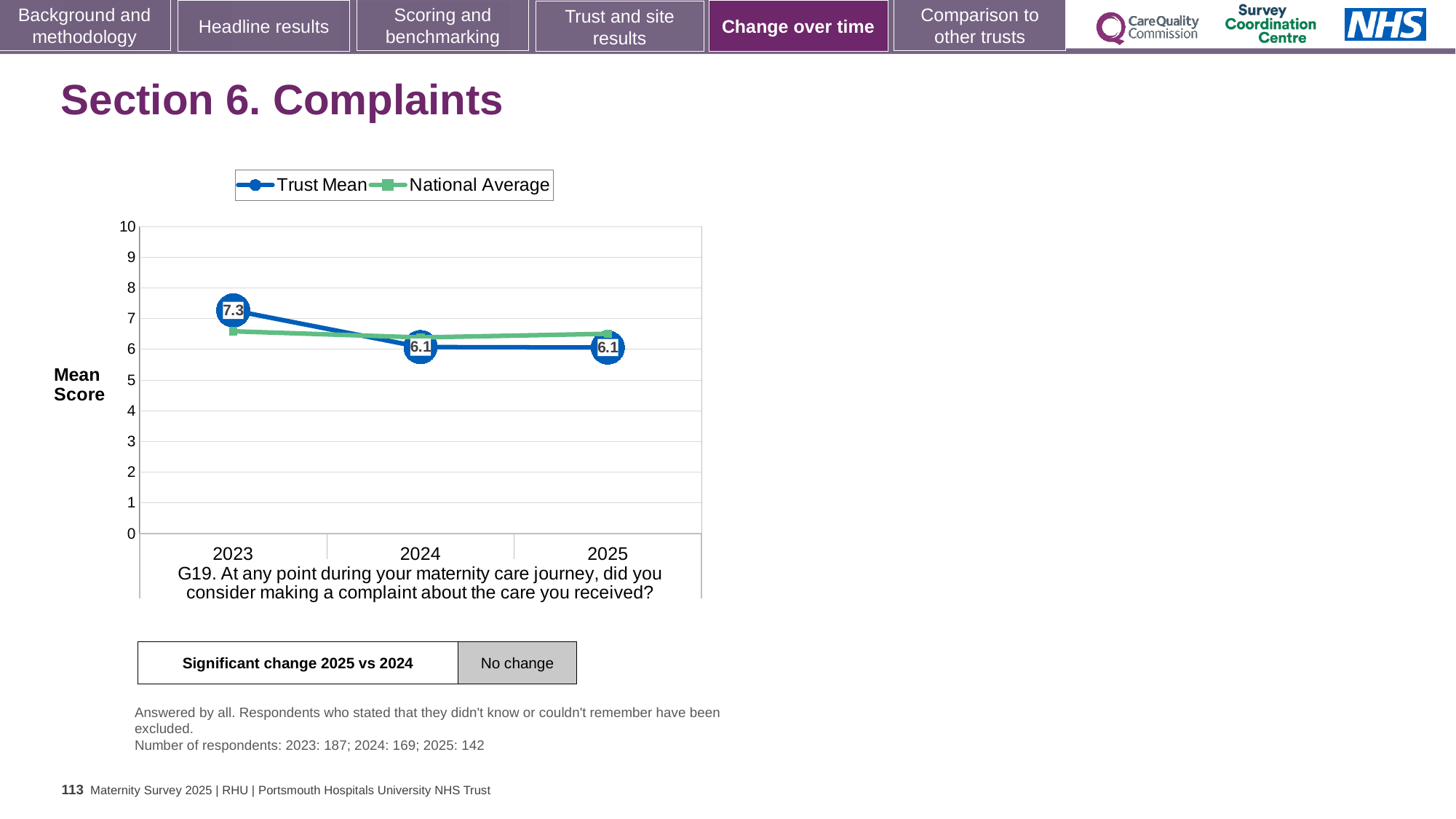
In 2025, which is larger: the Trust Mean or the National Average? National Average What is the Trust Mean score for 2025? 6.1 How many years are shown on the x axis of the chart? 3 Is the National Average value for 2024 greater or less than 6? greater How many series does the chart legend list? 2 In 2023, which is larger: the Trust Mean or the National Average? Trust Mean Does the Trust Mean rise or fall from 2023 to 2025? fall What is the Trust Mean score for 2024? 6.1 What is the Trust Mean score for 2023? 7.3 What is the difference between the Trust Mean score in 2023 and in 2024? 1.2 Is the National Average value for 2023 greater or less than 7? less In which year is the Trust Mean score highest? 2023